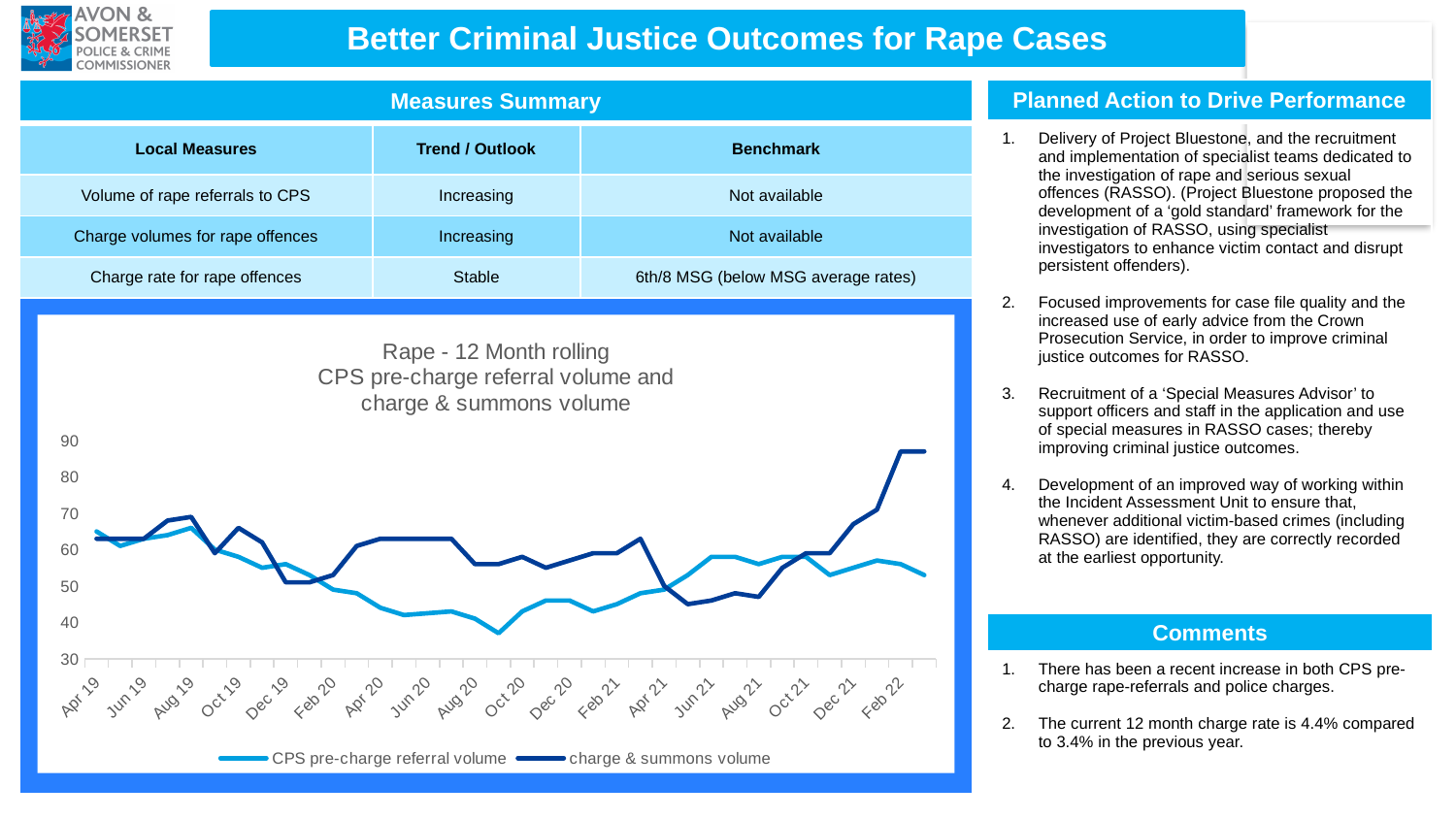
Is the charge & summons volume at Apr 19 greater or less than 60? greater Is the charge & summons volume at Jun 21 greater or less than 50? less At Feb 22, which series has the higher value: CPS pre-charge referral volume or charge & summons volume? charge & summons volume Is the charge & summons volume at Feb 22 greater or less than 80? greater How many series does the chart's legend list? 2 At Jun 21, which series has the higher value: CPS pre-charge referral volume or charge & summons volume? CPS pre-charge referral volume What is the title of the chart? Rape - 12 Month rolling CPS pre-charge referral volume and charge & summons volume In which month does the charge & summons volume reach its highest value? Feb 22 Does the charge & summons volume rise or fall between Oct 21 and Feb 22? Rise What kind of chart is shown on the slide? Line chart What are the two series named in the chart's legend? CPS pre-charge referral volume and charge & summons volume